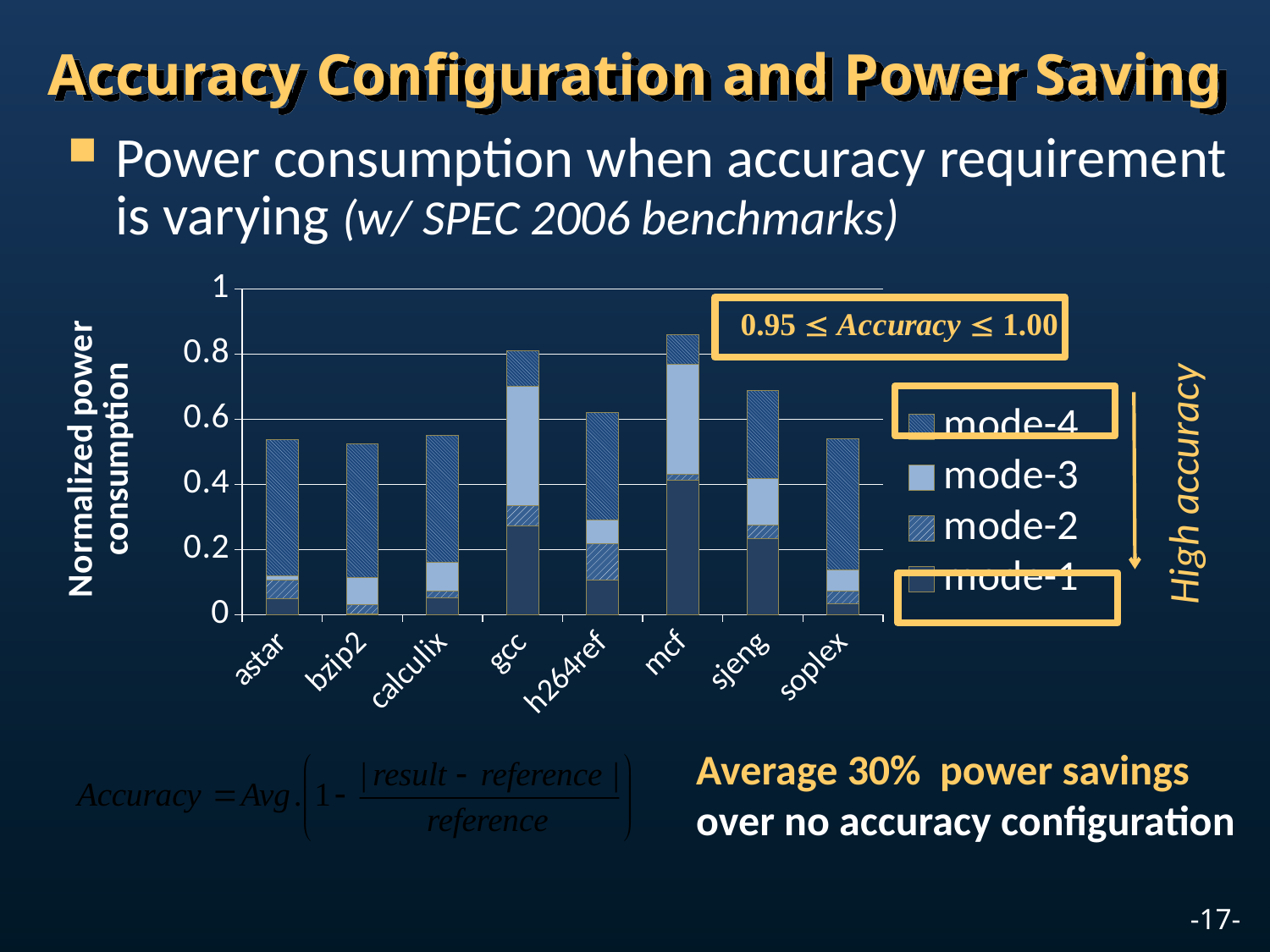
What kind of chart is shown on the slide? Stacked bar chart Which benchmark has the highest total normalized power consumption? mcf Is the total normalized power consumption for mcf greater or less than 0.8? greater Is the total normalized power consumption for h264ref greater or less than 0.8? less Which has a larger total normalized power consumption, gcc or sjeng? gcc Is the total normalized power consumption for bzip2 greater or less than 0.6? less Which has a larger total normalized power consumption, mcf or astar? mcf What is the label of the y axis? Normalized power consumption How many benchmark categories are plotted along the x axis? 8 How many series does the legend list? 4 What are the four series names listed in the legend? mode-4, mode-3, mode-2, mode-1